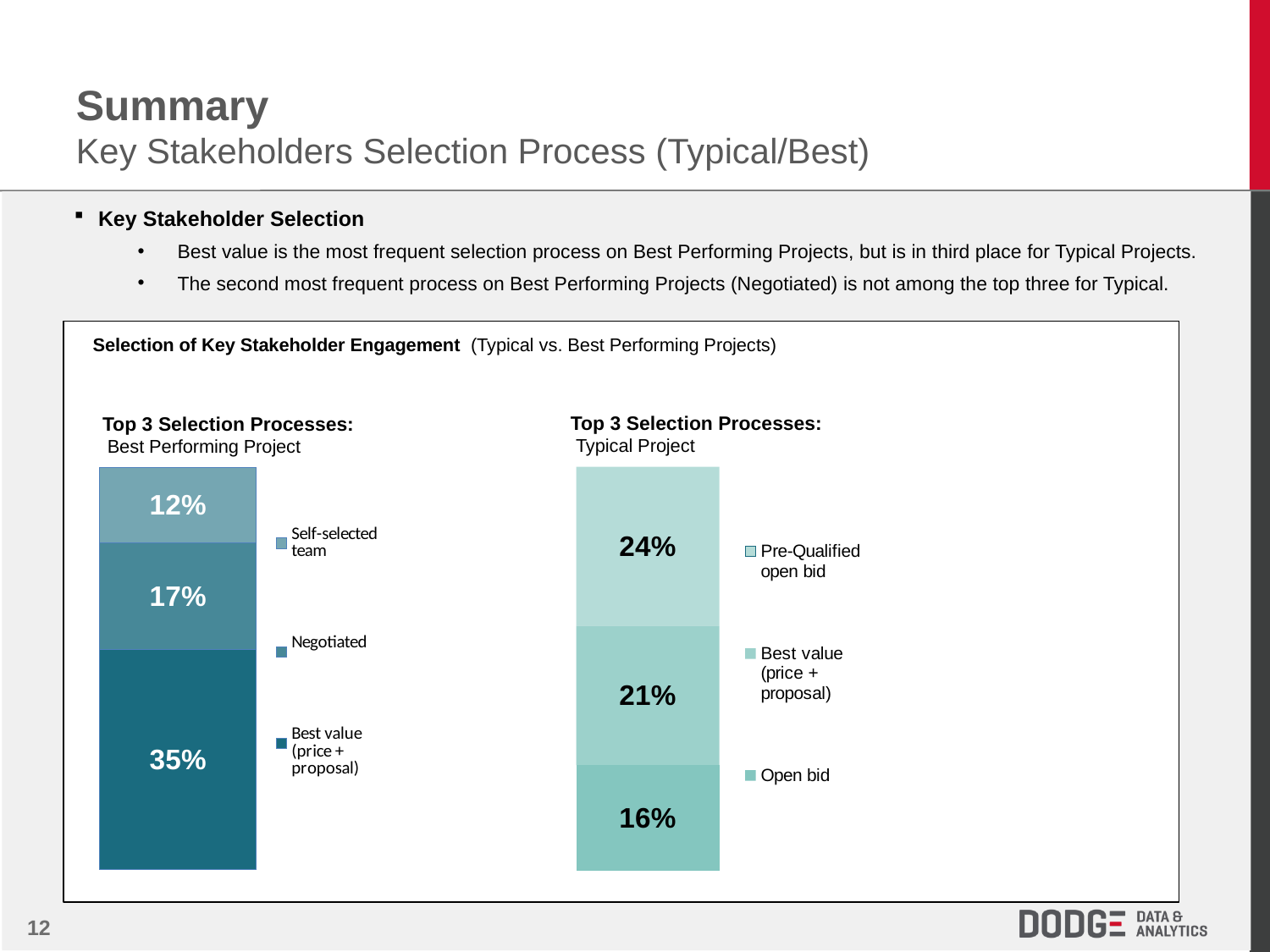
What is the total of the stacked bar in the Best Performing Project chart? 64% In the Best Performing Project chart, which selection process has the highest value? Best value (price + proposal) In the Typical Project chart, which is larger: Pre-Qualified open bid or Best value (price + proposal)? Pre-Qualified open bid In the Typical Project chart, what is the value for Open bid? 16% In the Typical Project chart, what is the value for Pre-Qualified open bid? 24% In the Best Performing Project chart, what is the value for Best value (price + proposal)? 35% How many series does the legend of the Typical Project chart list? 3 What is the total of the stacked bar in the Typical Project chart? 61% What is the difference between Best value (price + proposal) in the Best Performing Project chart and Best value (price + proposal) in the Typical Project chart? 14% In the Typical Project chart, which selection process has the lowest value? Open bid What kind of chart is the Best Performing Project chart? Stacked bar chart In the Best Performing Project chart, what is the value for Negotiated? 17%